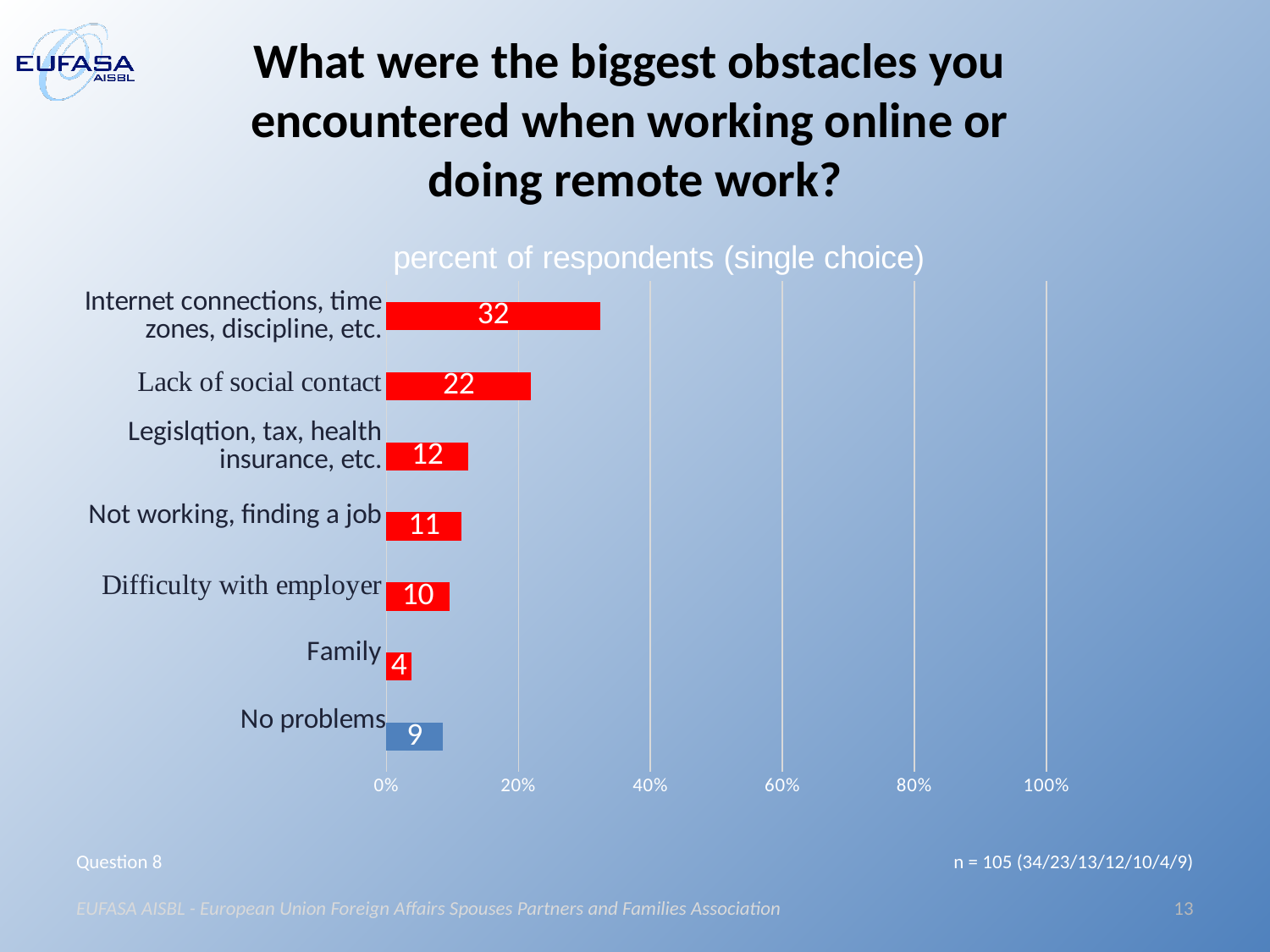
Which category has the highest value? Internet connections, time zones, discipline, etc. Is the value for "Internet connections, time zones, discipline, etc." greater or less than 20%? greater How many categories are shown in the chart? 7 What is the title of the chart? percent of respondents (single choice) What is the value for "Lack of social contact"? 22 Which is larger, the value for "Not working, finding a job" or the value for "No problems"? Not working, finding a job Which category has the lowest value? Family What kind of chart is shown on the slide? bar chart What is the value for "No problems"? 9 What is the value for "Difficulty with employer"? 10 Which category's bar is coloured blue rather than red? No problems What is the difference between the values for "Internet connections, time zones, discipline, etc." and "Lack of social contact"? 10